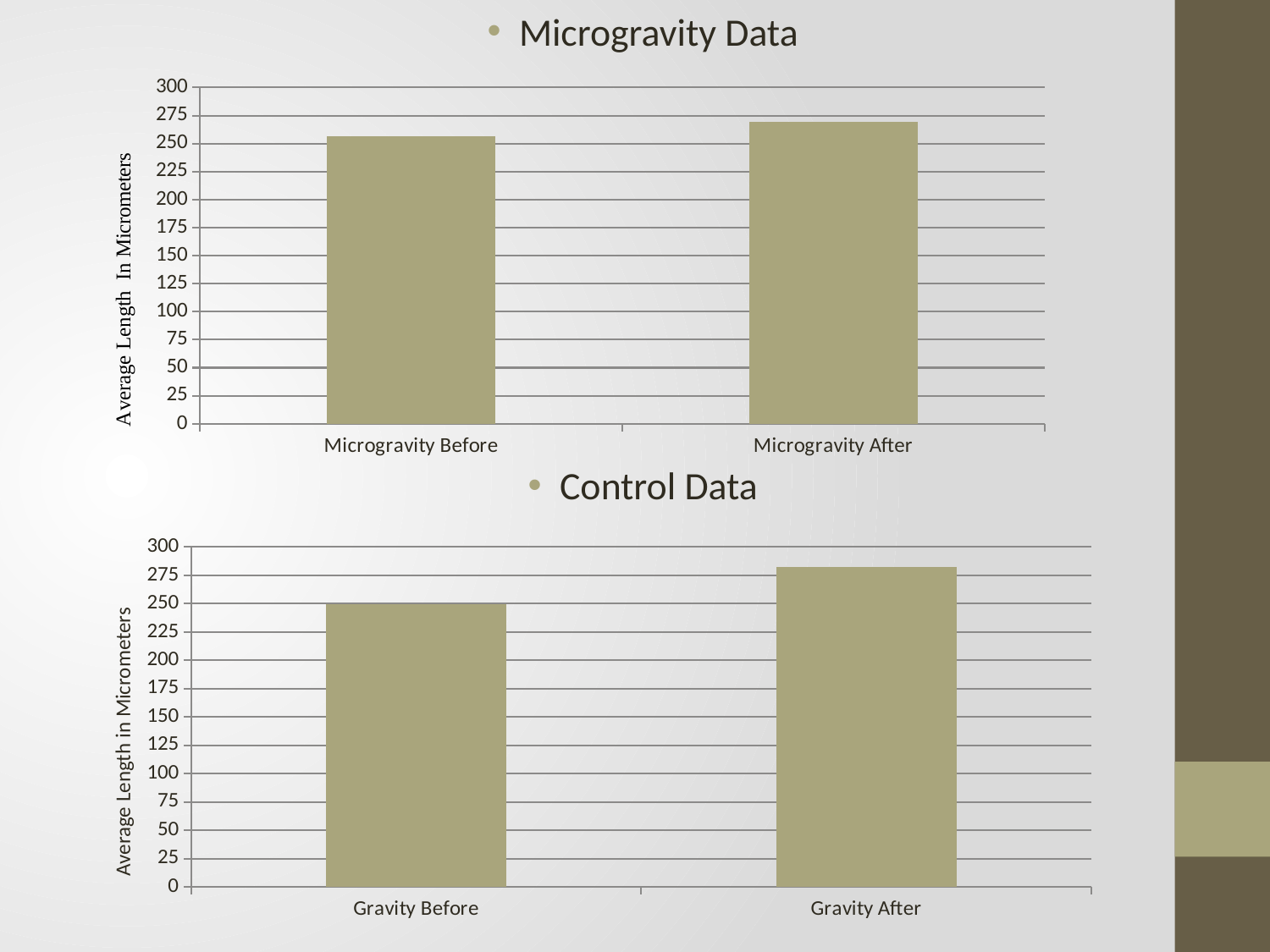
In the Microgravity Data chart, what kind of chart is shown? bar chart In the Control Data chart, is the value for Gravity Before greater or less than 275? less In the Microgravity Data chart, is the value for Microgravity Before greater or less than 275? less In the Microgravity Data chart, which category has the higher value? Microgravity After In the Microgravity Data chart, what is the y-axis title? Average Length In Micrometers In the Control Data chart, is the value for Gravity After greater or less than 275? greater In the Control Data chart, which category has the lower value? Gravity Before In the Control Data chart, what is the highest value shown on the y axis? 300 In the Microgravity Data chart, how many categories are plotted? 2 In the Control Data chart, which is larger, the value for Gravity Before or Gravity After? Gravity After